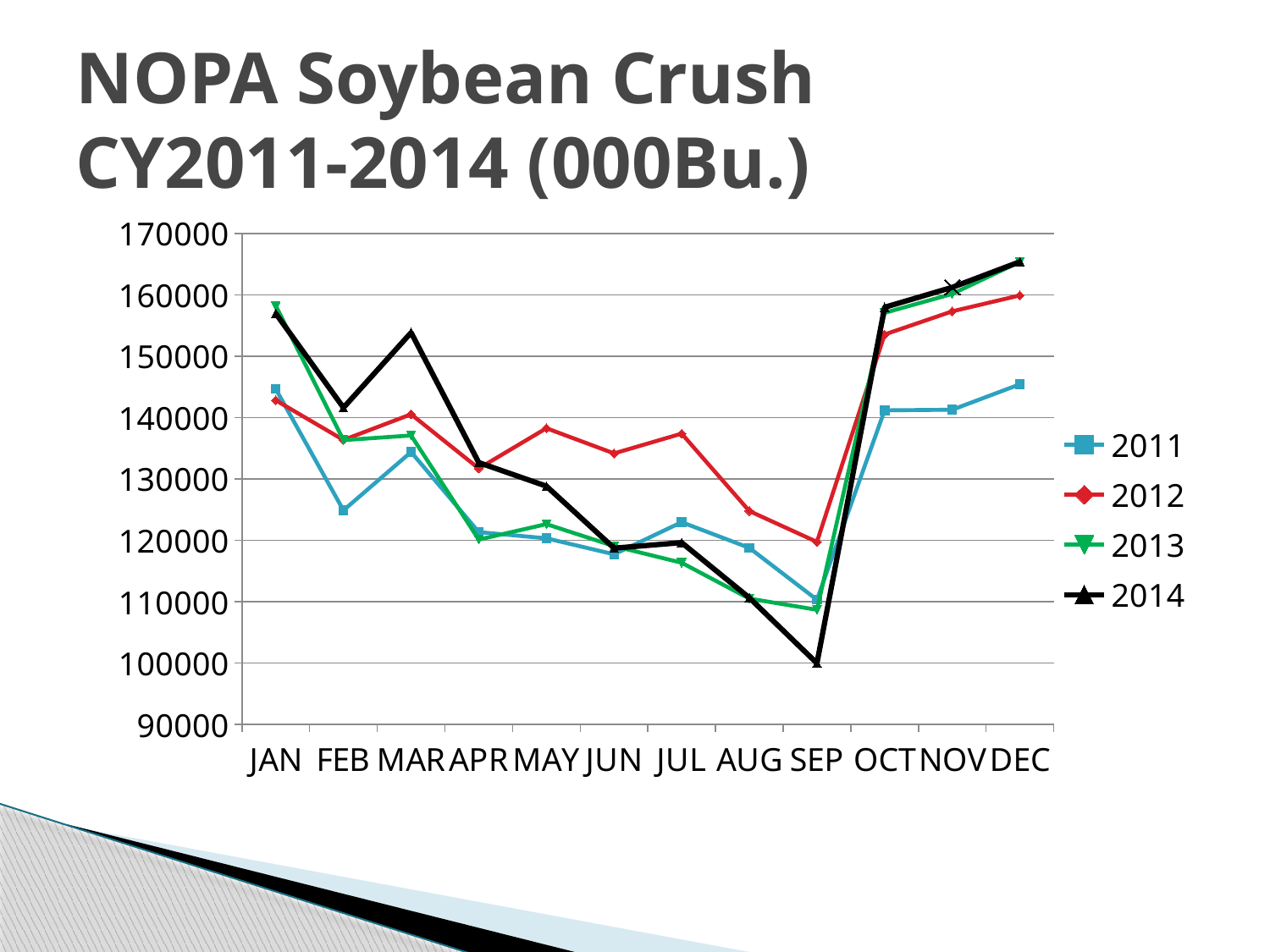
Which series is drawn with the black line? 2014 Which series has the highest value in JUL? 2012 In which month does the 2014 series reach its lowest value? SEP What kind of chart is shown on the slide? line chart Is the value for 2014 in SEP greater or less than 110000? less Is the value for 2011 in DEC greater or less than 140000? greater What is the title of the chart? NOPA Soybean Crush CY2011-2014 (000Bu.) Is the value for 2014 in MAR greater or less than 150000? greater In MAR, which is larger, the value for 2014 or the value for 2011? 2014 How many months are shown along the x axis? 12 How many series does the legend list? 4